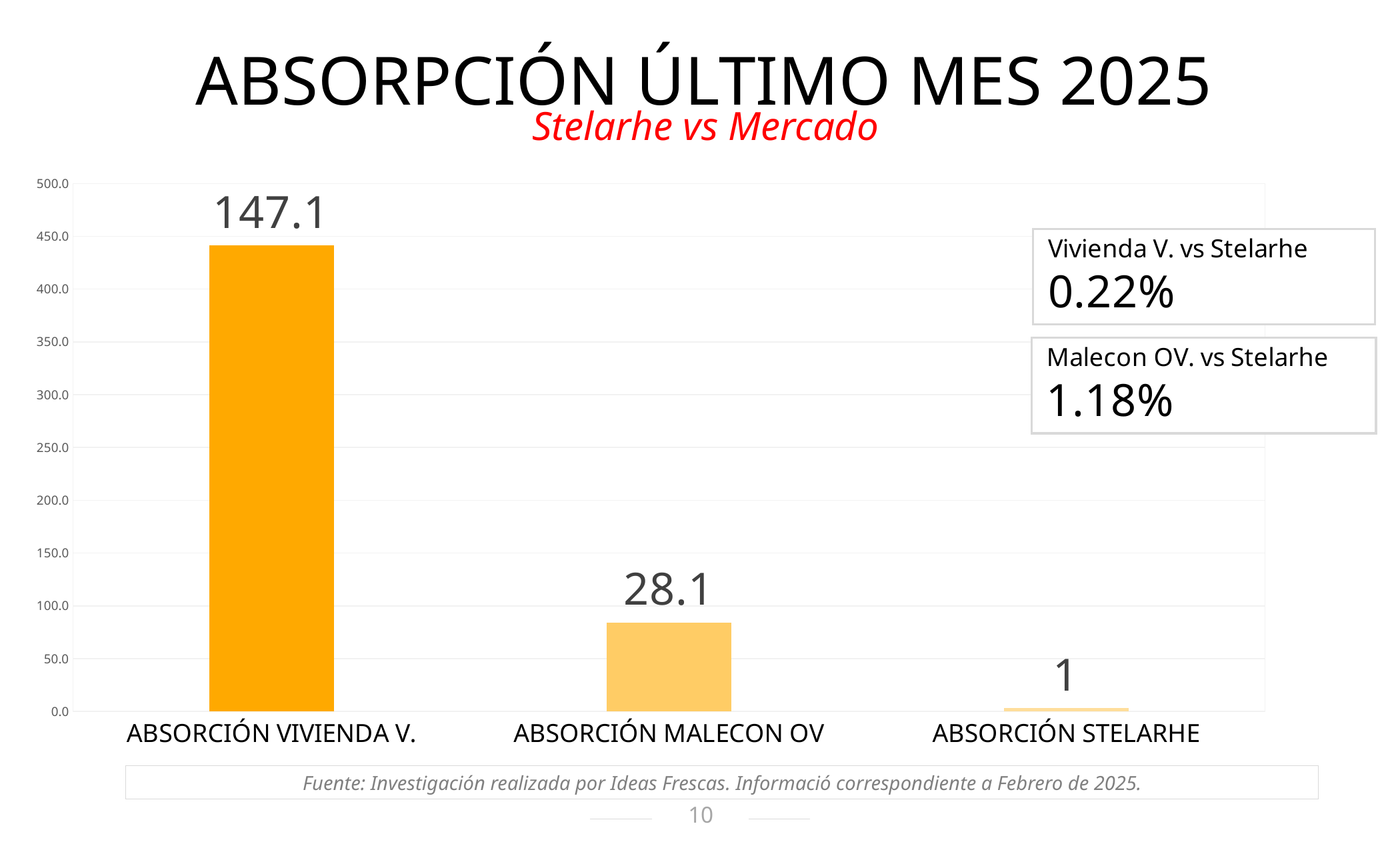
What is the difference between the values for ABSORCIÓN MALECON OV and ABSORCIÓN STELARHE? 27.1 What is the value for ABSORCIÓN VIVIENDA V.? 147.1 What is the value for ABSORCIÓN STELARHE? 1 How many categories are shown in the chart? 3 What is the value for ABSORCIÓN MALECON OV? 28.1 What is the title of the chart on the slide? ABSORPCIÓN ÚLTIMO MES 2025 Which category has the highest value? ABSORCIÓN VIVIENDA V. What kind of chart is shown on the slide? Bar chart Do the values rise or fall from left to right across the categories? Fall What is the difference between the values for ABSORCIÓN VIVIENDA V. and ABSORCIÓN MALECON OV? 119.0 Which is larger, the value for ABSORCIÓN MALECON OV or the value for ABSORCIÓN STELARHE? ABSORCIÓN MALECON OV Which category has the lowest value? ABSORCIÓN STELARHE